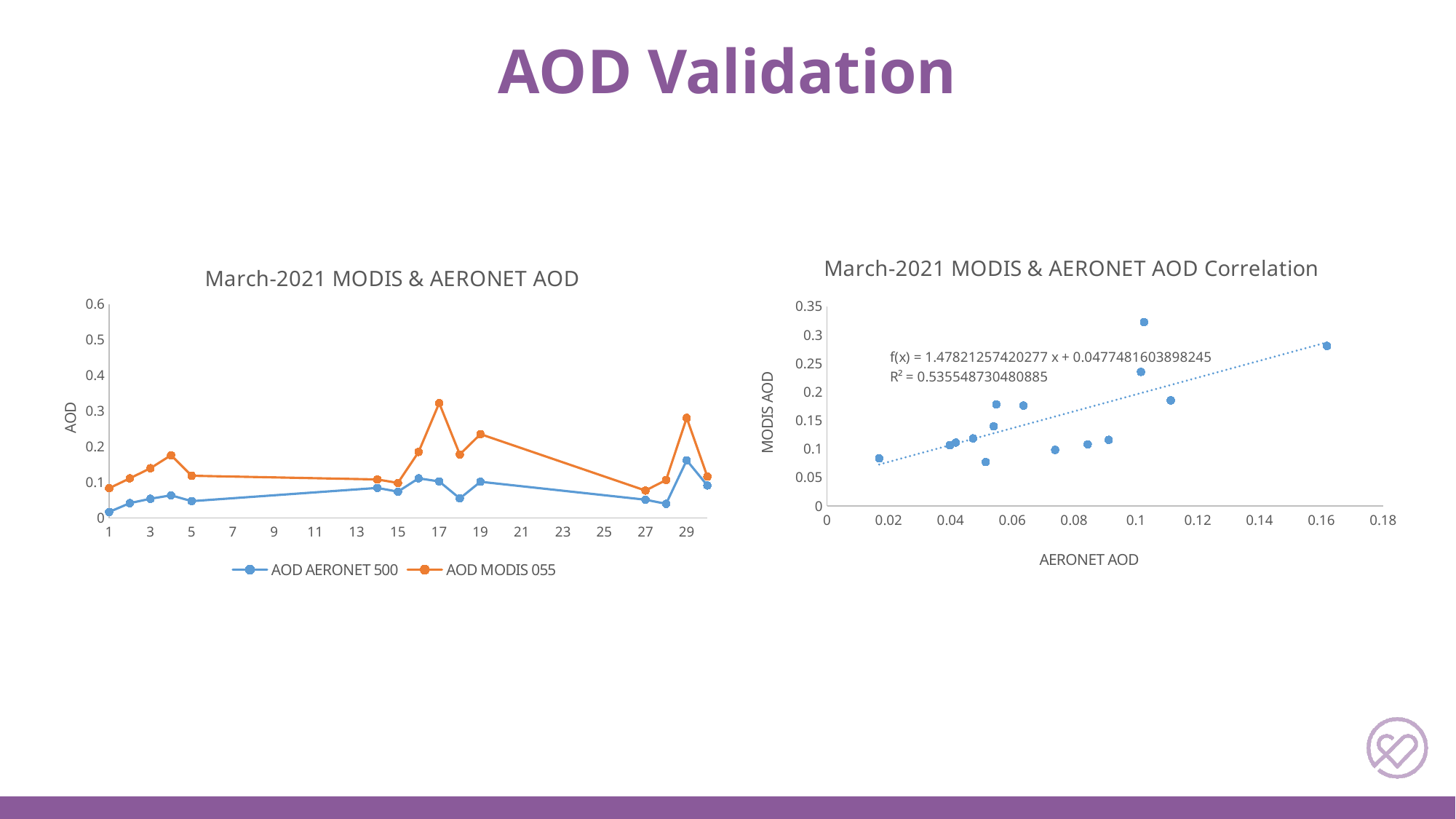
What kind of chart is the 'March-2021 MODIS & AERONET AOD Correlation' chart on the right? scatter chart In the 'March-2021 MODIS & AERONET AOD' chart, how many series does the legend list? 2 What kind of chart is the 'March-2021 MODIS & AERONET AOD' chart on the left? line chart In the 'March-2021 MODIS & AERONET AOD' chart, on which day does AOD MODIS 055 reach its highest value? 17 In the 'March-2021 MODIS & AERONET AOD' chart, is the AOD MODIS 055 value on day 4 greater or less than 0.2? less In the 'March-2021 MODIS & AERONET AOD Correlation' chart, what R² value is printed? 0.535548730480885 In the 'March-2021 MODIS & AERONET AOD' chart, what are the two legend entries? AOD AERONET 500 and AOD MODIS 055 In the 'March-2021 MODIS & AERONET AOD' chart, is the AOD AERONET 500 value on day 29 greater or less than 0.1? greater In the 'March-2021 MODIS & AERONET AOD' chart, which series has the higher value on day 17? AOD MODIS 055 In the 'March-2021 MODIS & AERONET AOD' chart, is the AOD MODIS 055 value on day 17 greater or less than 0.3? greater In the 'March-2021 MODIS & AERONET AOD' chart, does the AOD MODIS 055 series rise or fall from day 1 to day 4? rise In the 'March-2021 MODIS & AERONET AOD' chart, on which day is the AOD AERONET 500 value lowest? 1